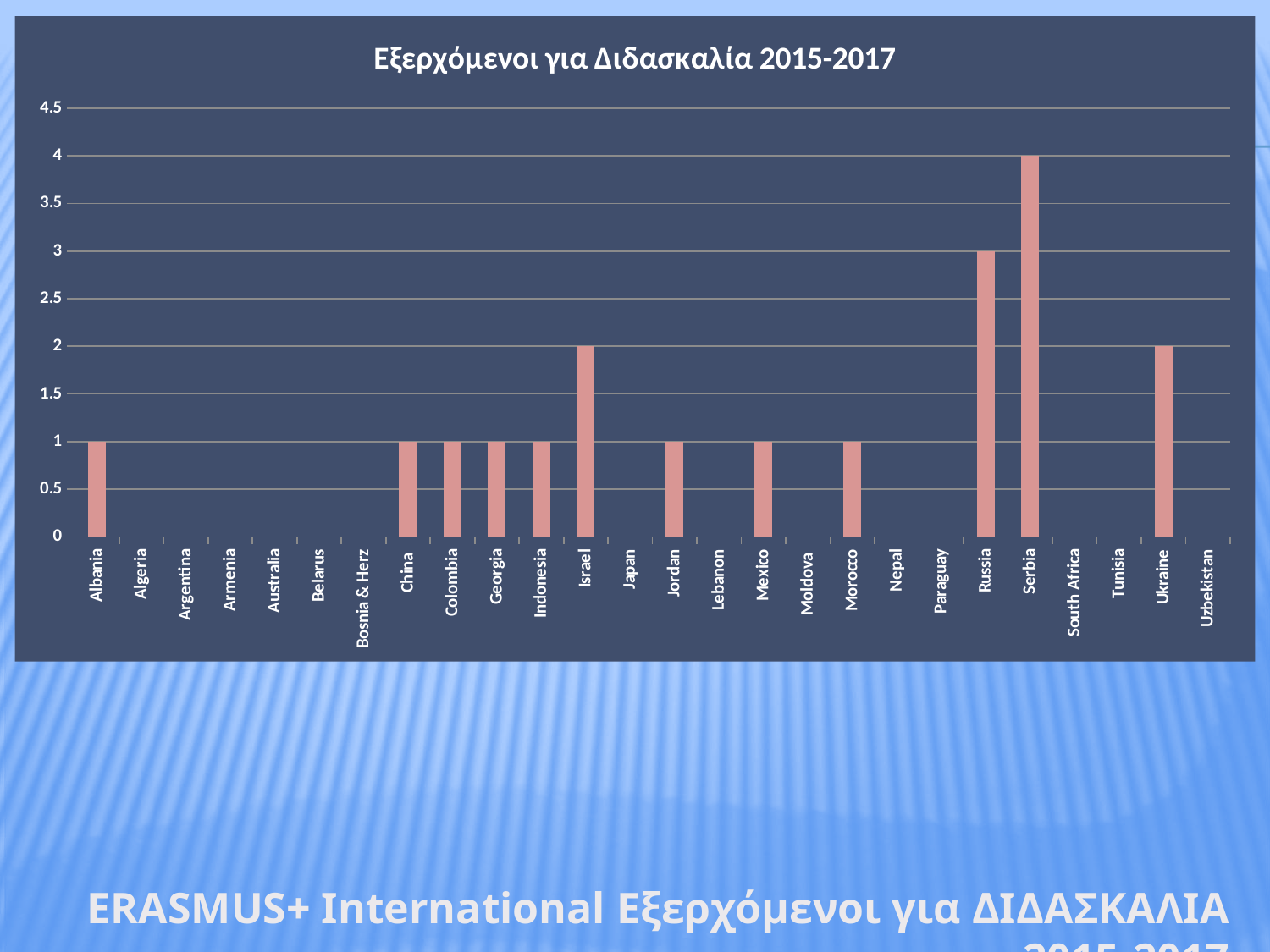
What is the value for Serbia? 4 What kind of chart is shown on the slide? bar chart What is the value for Russia? 3 What is the difference between the values for Serbia and Russia? 1 What is the value for Ukraine? 2 What is the value for Albania? 1 Which has a larger value, Russia or Ukraine? Russia Which country has the highest value? Serbia What is the difference between the values for Russia and Israel? 1 Is the value for Serbia greater or less than 3.5? greater How many countries are listed on the x axis? 26 What is the value for Israel? 2